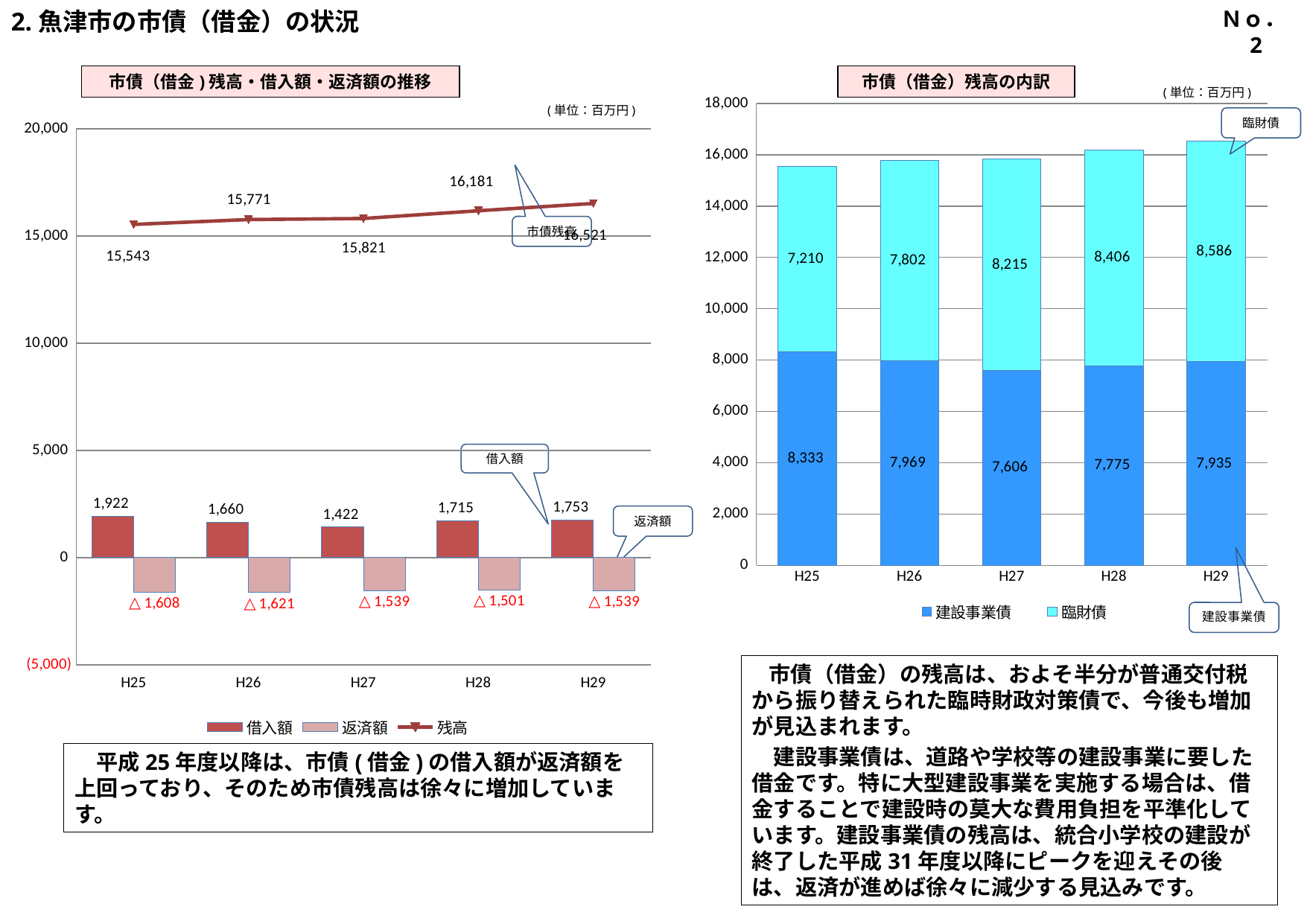
In the left chart (市債（借金）残高・借入額・返済額の推移), what is the 残高 value for H29? 16,521 In the left chart (市債（借金）残高・借入額・返済額の推移), how many series does the legend list? 3 In the right chart (市債（借金）残高の内訳), what is the total of the stacked bar for H29? 16,521 In the right chart (市債（借金）残高の内訳), which year has the highest 建設事業債 value? H25 In the left chart (市債（借金）残高・借入額・返済額の推移), which year has the lowest 借入額? H27 In the left chart (市債（借金）残高・借入額・返済額の推移), does the 残高 line rise or fall from H25 to H29? rise In the left chart (市債（借金）残高・借入額・返済額の推移), what is the 借入額 value for H25? 1,922 In the right chart (市債（借金）残高の内訳), what is the 臨財債 value for H27? 8,215 In the left chart (市債（借金）残高・借入額・返済額の推移), what is the difference between the 借入額 for H25 and H26? 262 What kind of chart is the right chart (市債（借金）残高の内訳)? stacked bar chart In the right chart (市債（借金）残高の内訳), which is larger for H26, 建設事業債 or 臨財債? 建設事業債 In the right chart (市債（借金）残高の内訳), what is the 建設事業債 value for H28? 7,775